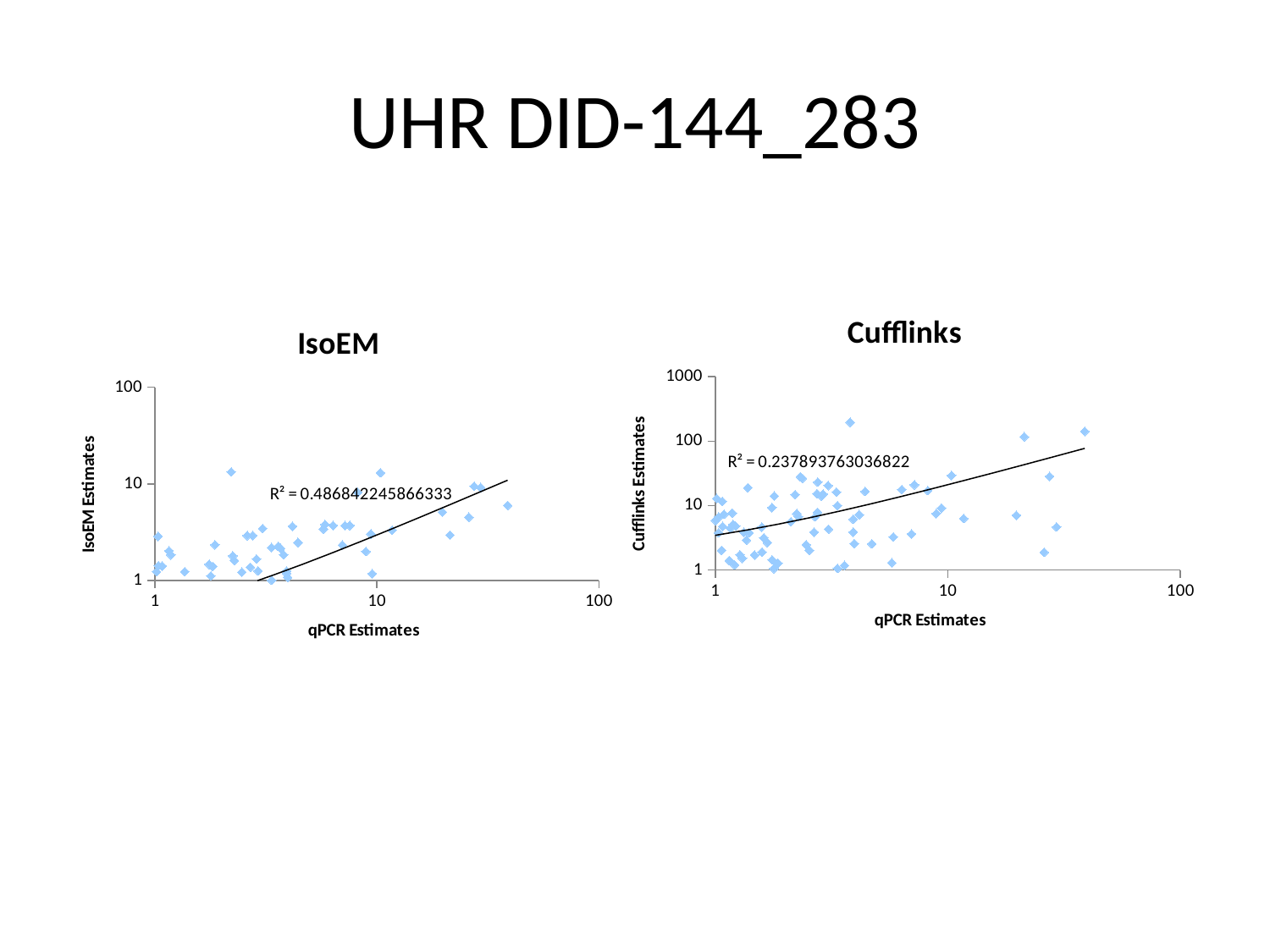
On the IsoEM chart, does the fitted trend line rise or fall as qPCR Estimates increase? rise On the Cufflinks chart, does the fitted trend line rise or fall as qPCR Estimates increase? rise What kind of chart is the IsoEM chart? scatter chart What is the y-axis title of the IsoEM chart? IsoEM Estimates What R² value is printed on the IsoEM chart? 0.486842245866333 What kind of chart is the Cufflinks chart? scatter chart What is the highest tick value shown on the y-axis of the Cufflinks chart? 1000 Which chart shows the higher R² value, IsoEM or Cufflinks? IsoEM What R² value is printed on the Cufflinks chart? 0.237893763036822 What is the highest tick value shown on the y-axis of the IsoEM chart? 100 What is the x-axis title of the Cufflinks chart? qPCR Estimates How many charts are shown on the slide? 2